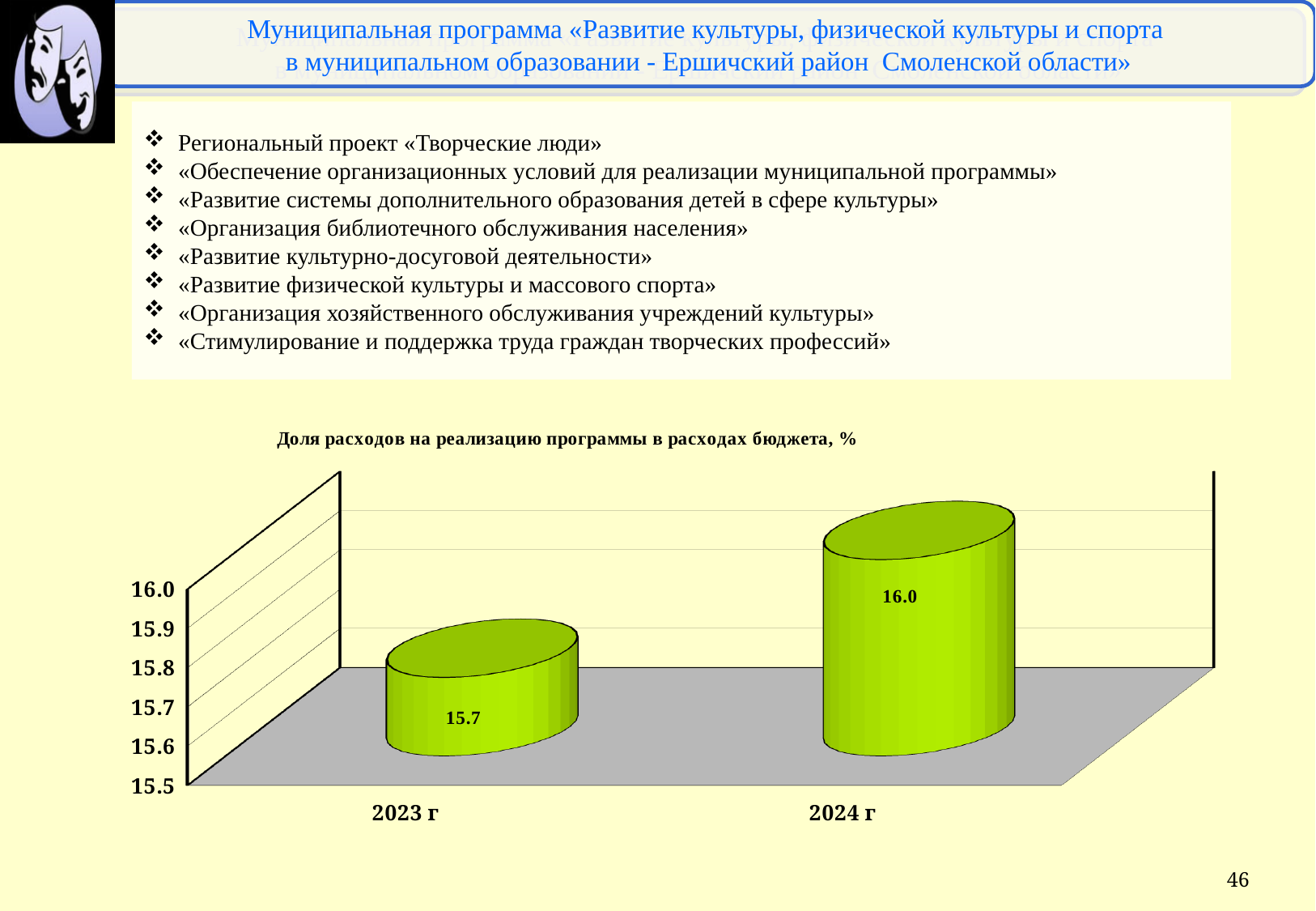
Do the values rise or fall from 2023 г to 2024 г? rise How many categories (years) are shown in the chart? 2 What is the value for 2024 г in the chart? 16.0 What is the lowest value shown on the vertical axis of the chart? 15.5 Which year has the lower share of programme expenditure in the budget? 2023 г What is the difference between the 2024 г and 2023 г values? 0.3 What kind of chart is shown on the slide? bar chart Is the value for 2024 г larger or smaller than the value for 2023 г? larger What is the value for 2023 г in the chart? 15.7 Is the value for 2023 г greater or less than 15.8? less Which year has the higher share of programme expenditure in the budget? 2024 г What is the title of the chart? Доля расходов на реализацию программы в расходах бюджета, %